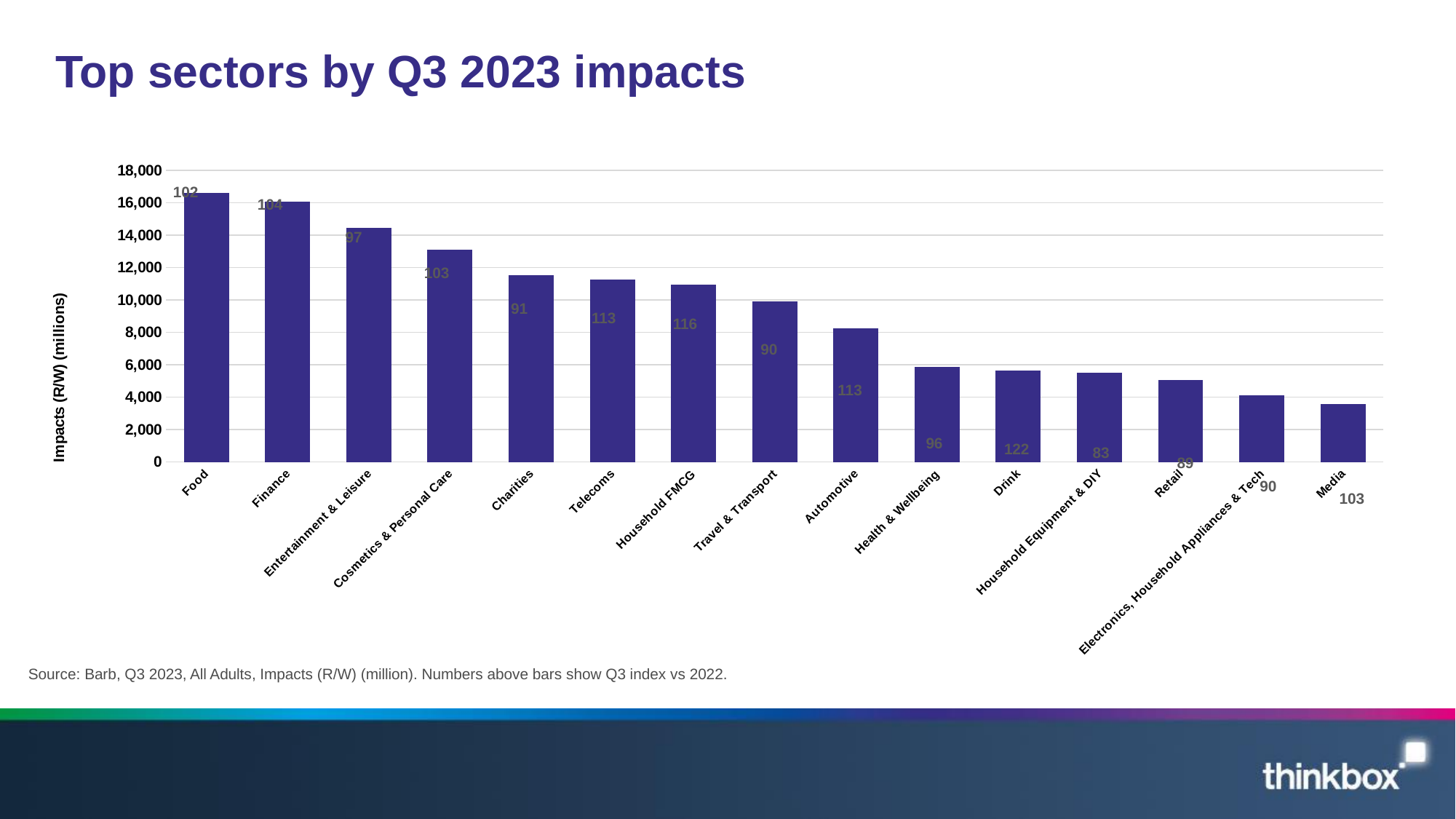
How many sectors are plotted on the chart? 15 Which sector has the highest Q3 2023 impacts? Food What kind of chart is shown on the slide? bar chart Which sector has the lowest Q3 2023 impacts? Media Which has higher Q3 2023 impacts, Telecoms or Automotive? Telecoms Which sector has the highest Q3 index vs 2022 shown above its bar? Drink Do the impacts values rise or fall moving from left to right along the x axis? fall Is the impacts value for Charities greater or less than 12,000? less Is the impacts value for Entertainment & Leisure greater or less than 14,000? greater What Q3 index vs 2022 is shown above the bar for Household Equipment & DIY? 83 What Q3 index vs 2022 is shown above the bar for Drink? 122 What Q3 index vs 2022 is shown above the bar for Household FMCG? 116